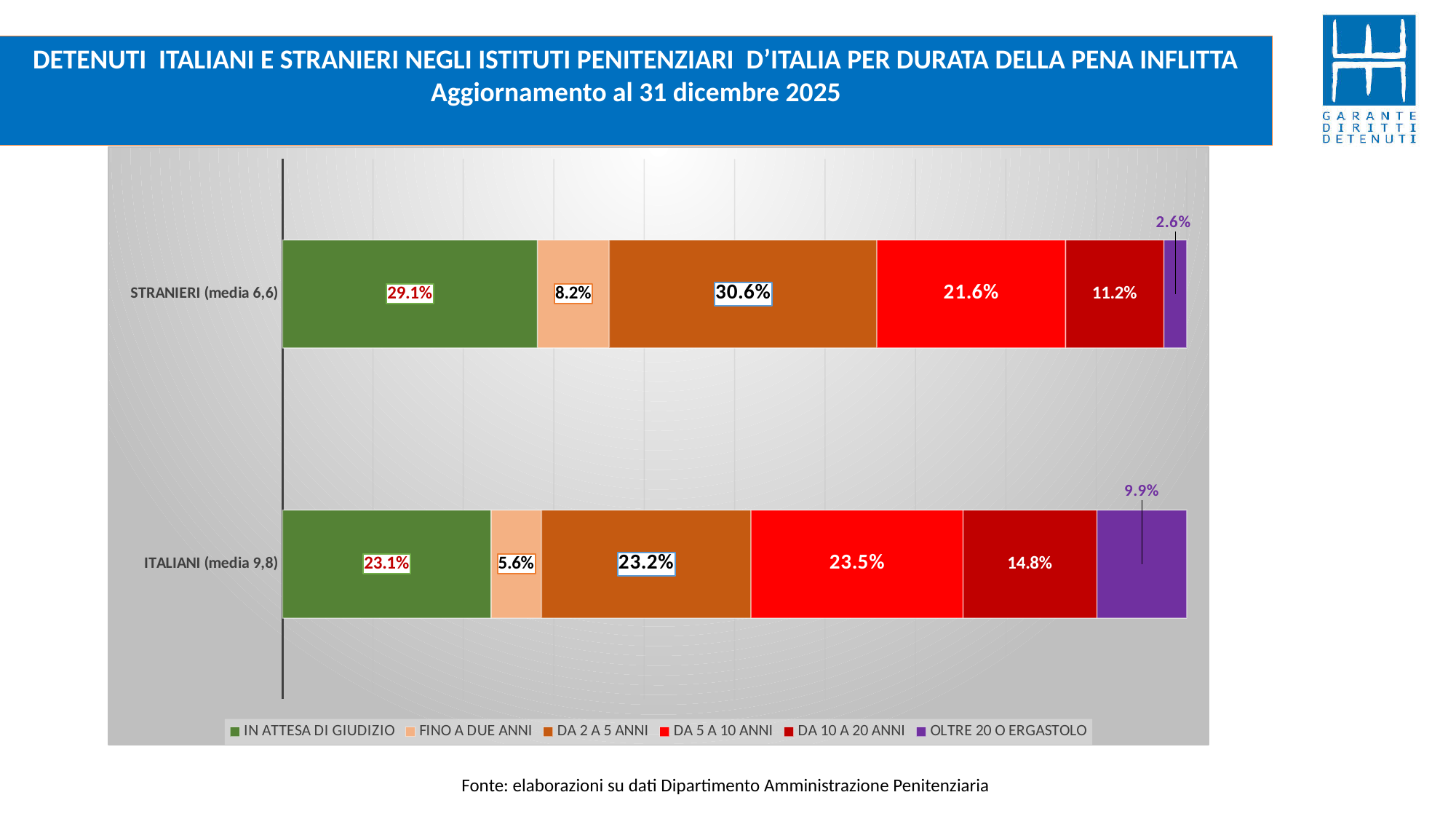
Which series has the smallest share in the STRANIERI bar? OLTRE 20 O ERGASTOLO Which series has the smallest share in the ITALIANI bar? FINO A DUE ANNI What is the value of DA 2 A 5 ANNI for STRANIERI? 30.6% What is the difference between the OLTRE 20 O ERGASTOLO values for ITALIANI and STRANIERI? 7.3 percentage points Which series has the largest share in the STRANIERI bar? DA 2 A 5 ANNI What is the value of DA 10 A 20 ANNI for ITALIANI? 14.8% How many categories (bars) are plotted in the chart? 2 Which category has the larger value for IN ATTESA DI GIUDIZIO, STRANIERI or ITALIANI? STRANIERI How many series does the legend list? 6 What is the value of OLTRE 20 O ERGASTOLO for ITALIANI? 9.9% What is the value of FINO A DUE ANNI for STRANIERI? 8.2% What kind of chart is shown on the slide? Stacked bar chart